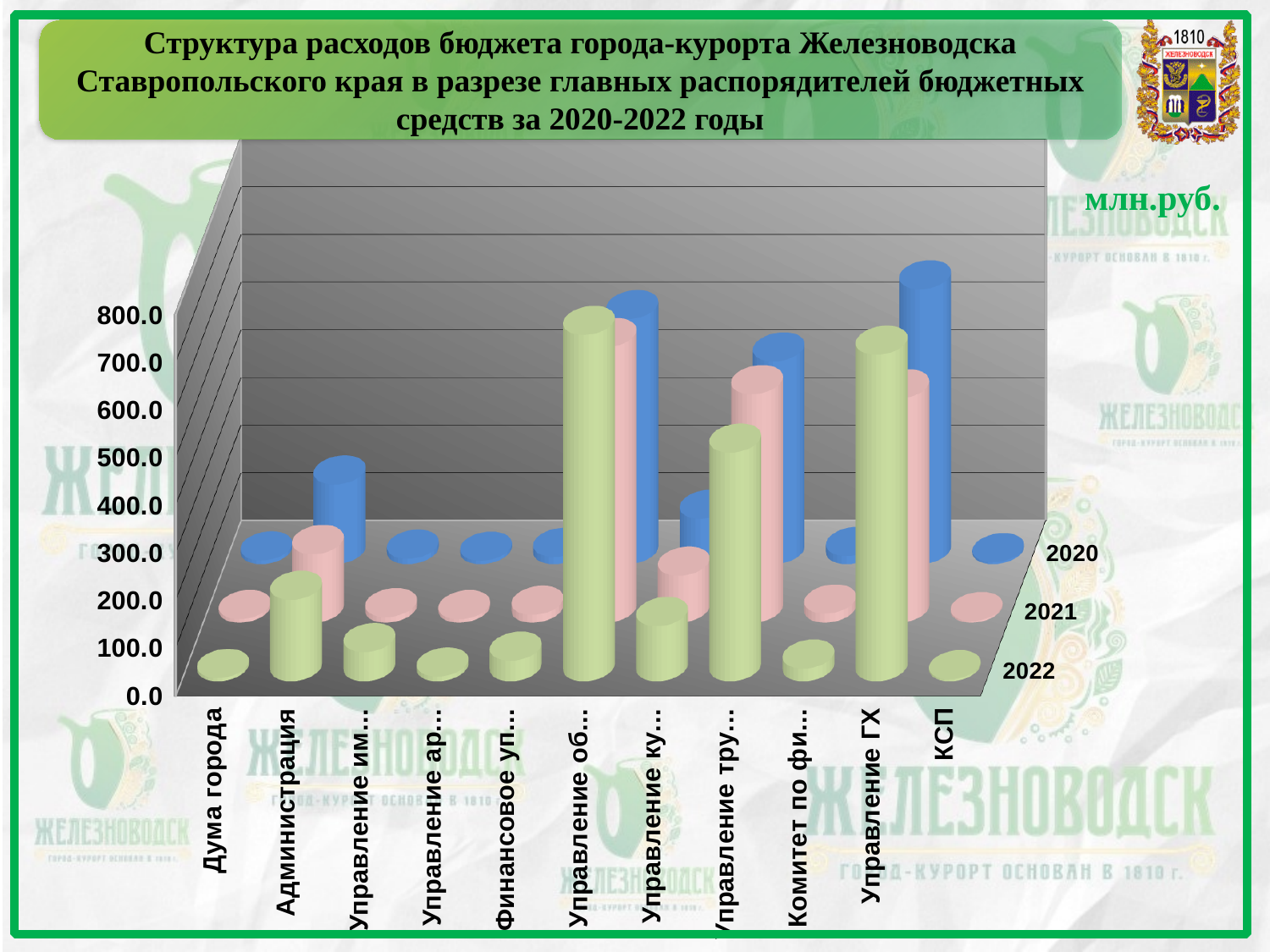
Is the value for Администрация in 2022 greater or less than 400? less Which years are shown as series in the chart? 2020, 2021, 2022 Is the value for Управление ГХ in 2022 greater or less than 400? greater Is the value for Управление об... in 2022 greater or less than 500? greater How many series (years) does the chart show? 3 What unit of measurement is indicated on the slide for the chart values? млн.руб. Which is larger in 2022: Администрация or Дума города? Администрация What kind of chart is shown on the slide? bar chart Which is larger in 2022: Управление ГХ or Управление тру...? Управление ГХ How many categories (main budget managers) are shown along the x axis? 11 Which category has the highest value in 2022? Управление об...